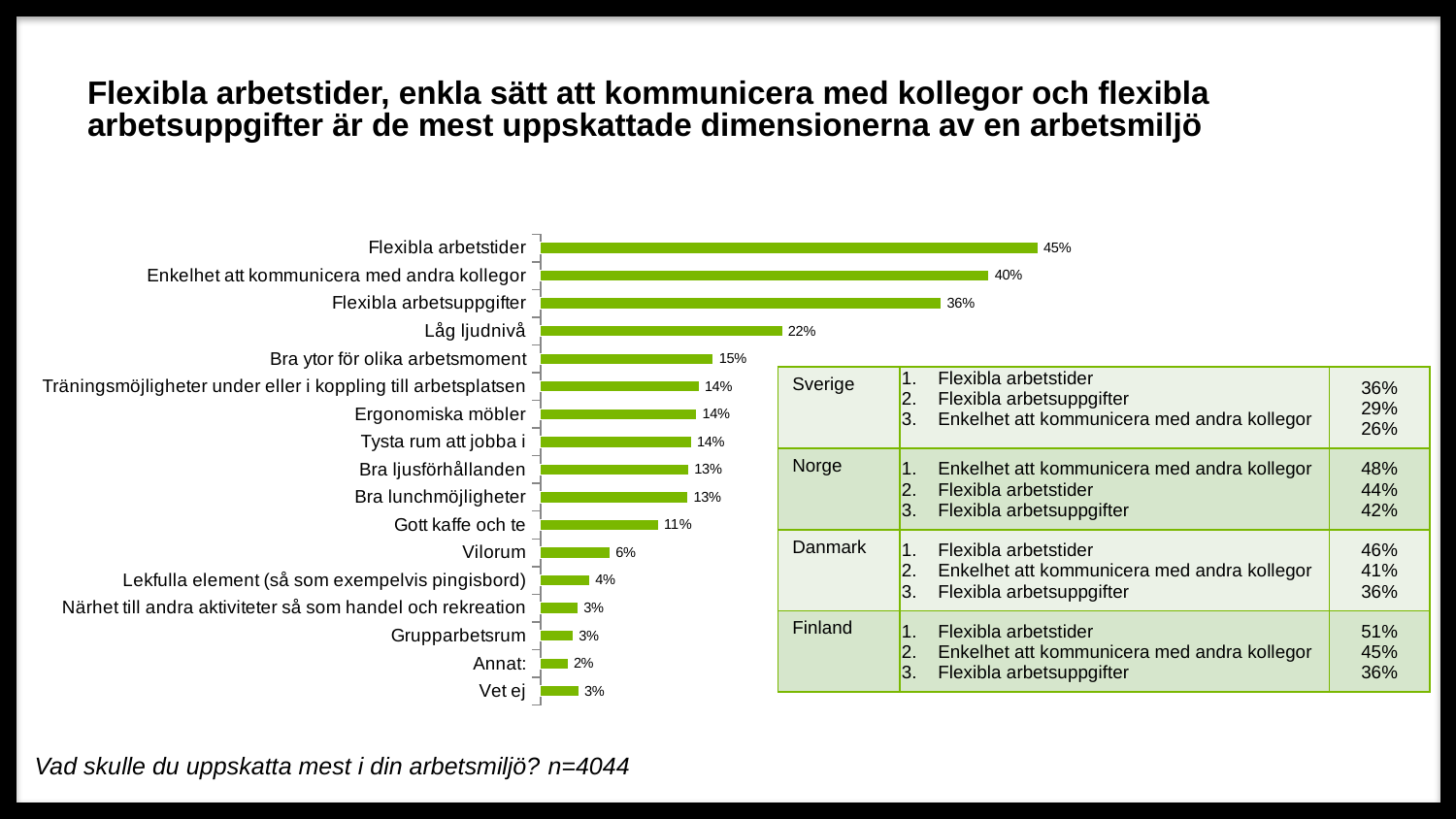
What is the difference between the values for Flexibla arbetstider and Flexibla arbetsuppgifter? 9% Which category has the highest value? Flexibla arbetstider What is the value for Gott kaffe och te? 11% What is the sample size (n) stated below the chart? n=4044 Which is larger, the value for Bra ytor för olika arbetsmoment or the value for Vilorum? Bra ytor för olika arbetsmoment What is the value for Flexibla arbetstider? 45% What is the value for Låg ljudnivå? 22% Which category has the lowest value? Annat: What kind of chart is shown on the slide? Bar chart What is the value for Vilorum? 6% What is the difference between the values for Enkelhet att kommunicera med andra kollegor and Låg ljudnivå? 18% How many categories are shown in the bar chart? 17